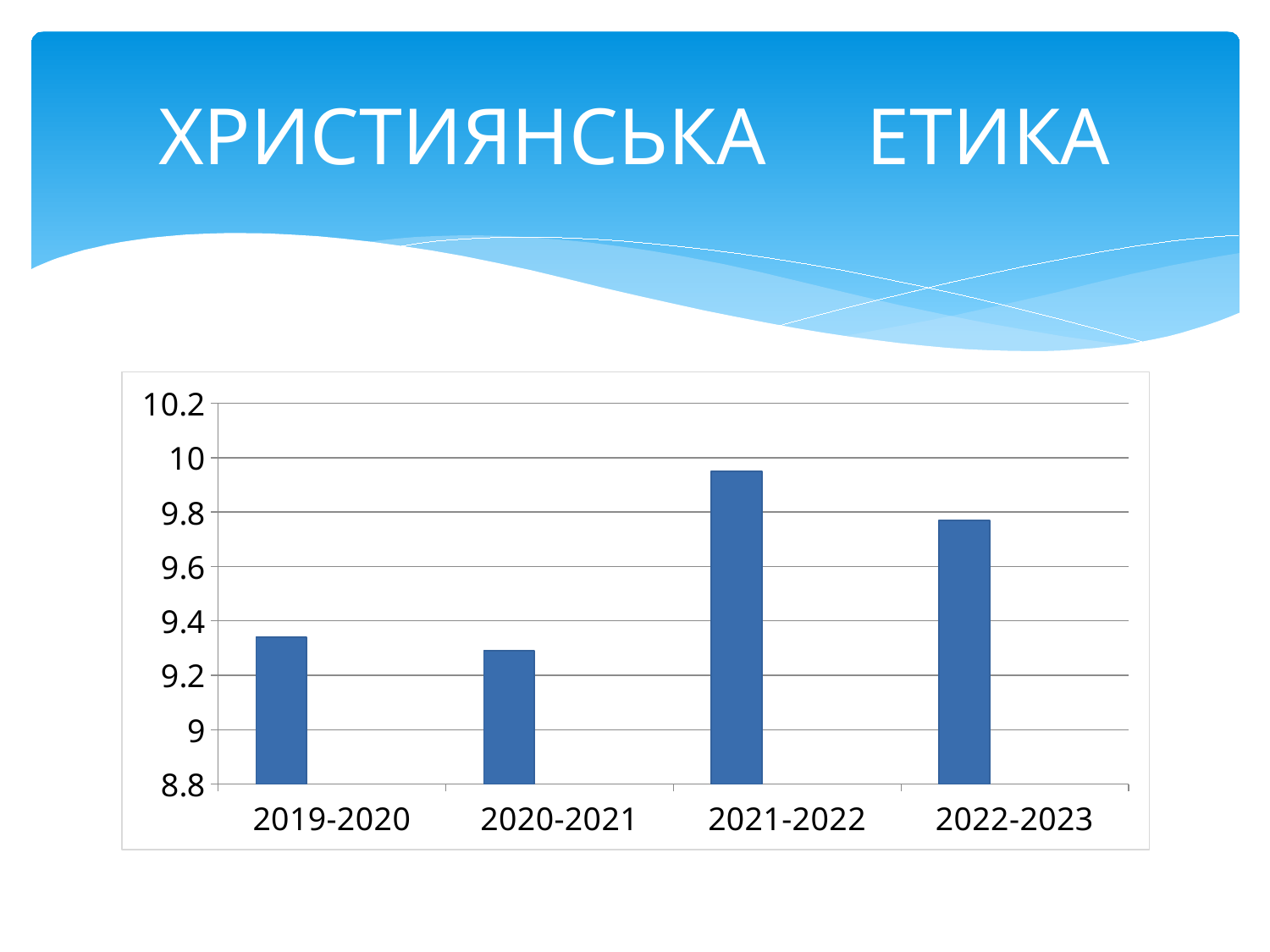
Is the value for 2021-2022 greater or less than 9.8? greater What is the title shown at the top of the slide above the chart? ХРИСТИЯНСЬКА ЕТИКА Which is larger, the value for 2019-2020 or the value for 2021-2022? 2021-2022 What kind of chart is shown on the slide? bar chart Is the value for 2019-2020 greater or less than 9.4? less Is the value for 2021-2022 greater or less than 10? less Which is larger, the value for 2021-2022 or the value for 2022-2023? 2021-2022 Which academic year has the highest bar in the chart? 2021-2022 Does the value rise or fall from 2020-2021 to 2021-2022? rise Which academic year has the lowest bar in the chart? 2020-2021 How many academic years (categories) are shown on the x axis of the chart? 4